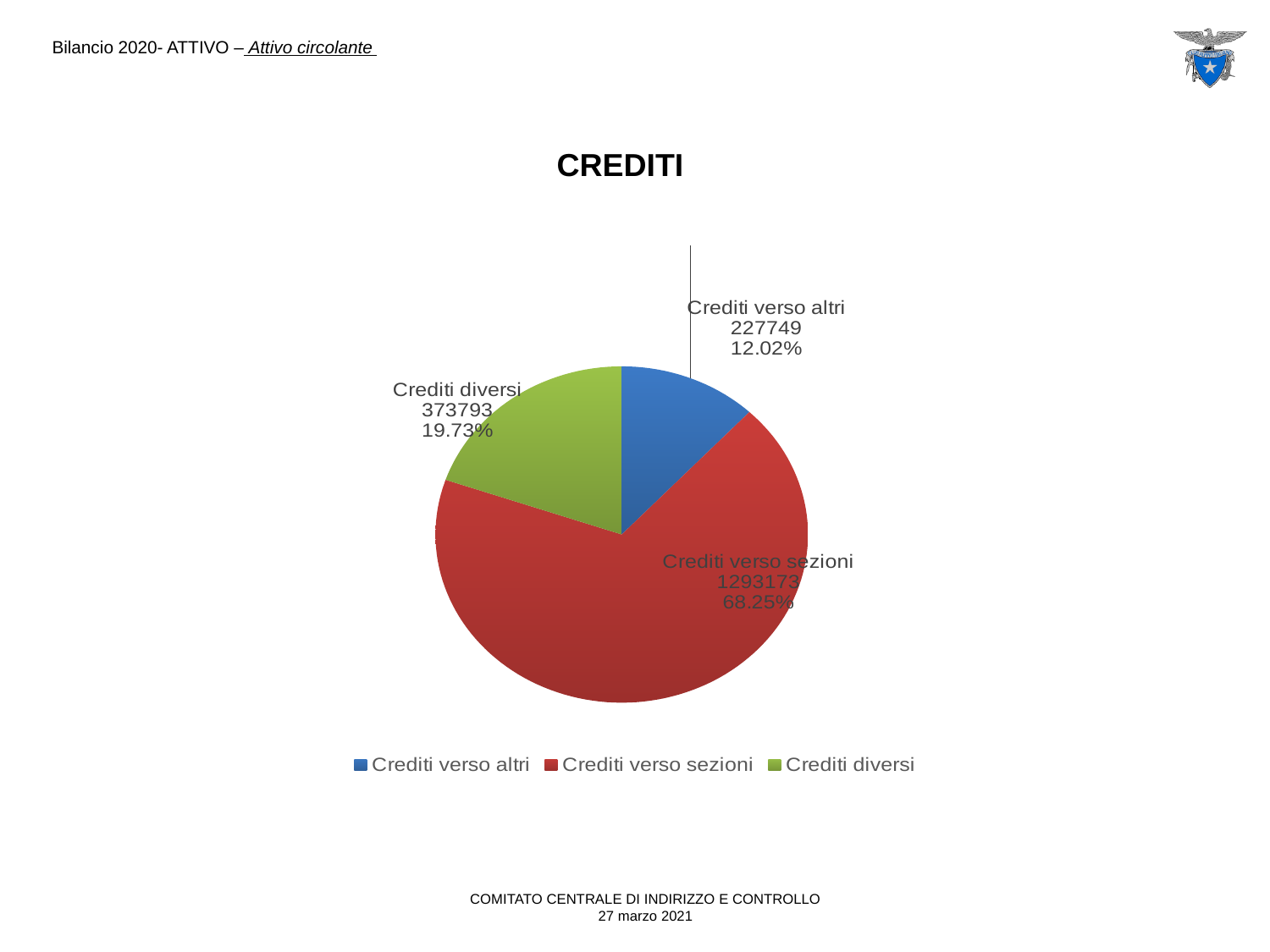
What share of the pie does Crediti diversi represent? 19.73% What is the difference between the values for Crediti diversi and Crediti verso altri? 146044 What is the value for Crediti diversi? 373793 Which category has the smallest slice? Crediti verso altri What share of the pie does Crediti verso sezioni represent? 68.25% What is the value for Crediti verso altri? 227749 Which is larger, Crediti diversi or Crediti verso altri? Crediti diversi What is the title of the chart? CREDITI What is the value for Crediti verso sezioni? 1293173 What type of chart is shown on the slide? pie chart How many slices does the pie chart have? 3 Which category has the largest slice? Crediti verso sezioni